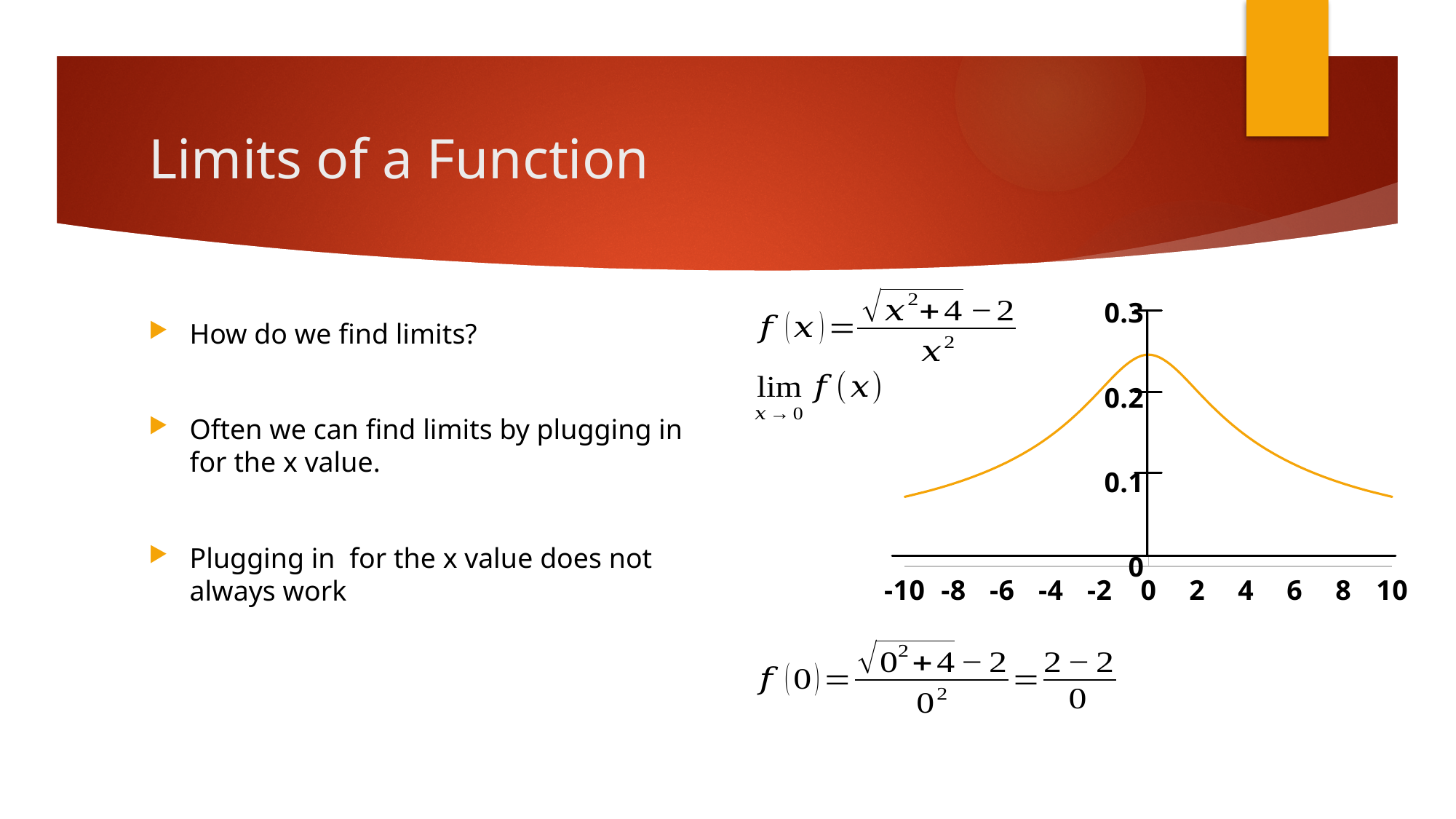
Does the curve rise or fall as x goes from -10 to 0? rise Which is larger, the value of the curve at x = 0 or at x = 10? x = 0 What is the highest tick label shown on the y axis of the chart? 0.3 Does the curve rise or fall as x goes from 0 to 10? fall What kind of chart is shown on the right of the slide? line chart Is the value of the curve at x = 0 greater or less than 0.3? less Is the value of the curve at x = 4 greater or less than 0.2? less Is the value of the curve at x = -10 greater or less than 0.1? less At which x value does the plotted curve reach its highest point? 0 How many tick labels are shown on the x axis of the chart? 11